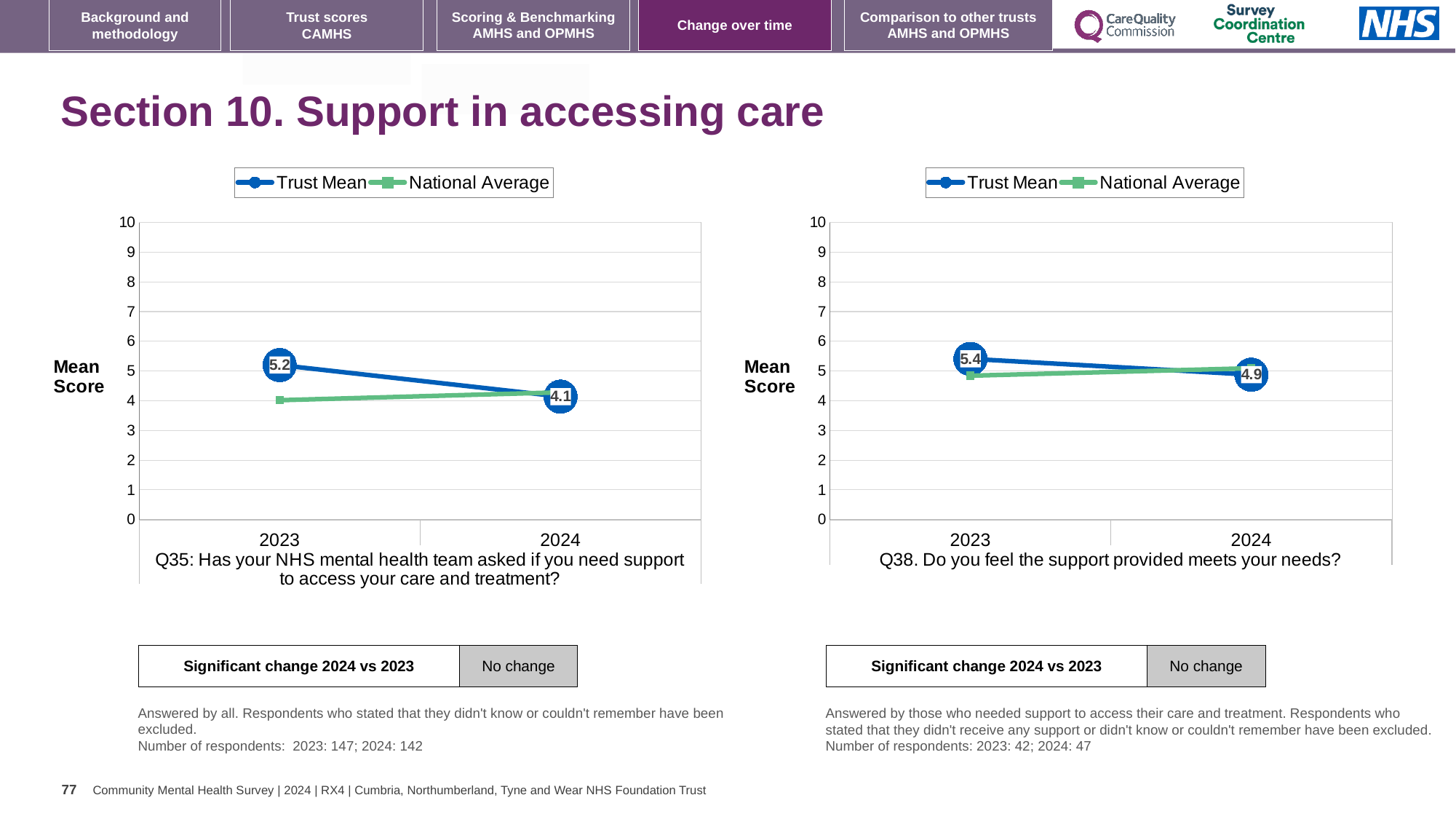
On the Q35 chart (left), does the Trust Mean rise or fall from 2023 to 2024? fall On the Q35 chart (left), by how much did the Trust Mean fall from 2023 to 2024? 1.1 On the Q35 chart (left), what is the Trust Mean score for 2024? 4.1 On the Q35 chart (left), is the National Average for 2023 greater or less than 5? less On the Q35 chart (left), what is the Trust Mean score for 2023? 5.2 How many series does the legend list on the Q38 chart (right)? 2 On the Q38 chart (right), what is the Trust Mean score for 2024? 4.9 On the Q35 chart (left), which is larger in 2023, the Trust Mean or the National Average? Trust Mean On the Q38 chart (right), what is the difference between the Trust Mean in 2023 and 2024? 0.5 On the Q38 chart (right), does the National Average rise or fall from 2023 to 2024? rise What type of chart is used on the Q35 chart (left)? line chart On the Q38 chart (right), what is the Trust Mean score for 2023? 5.4